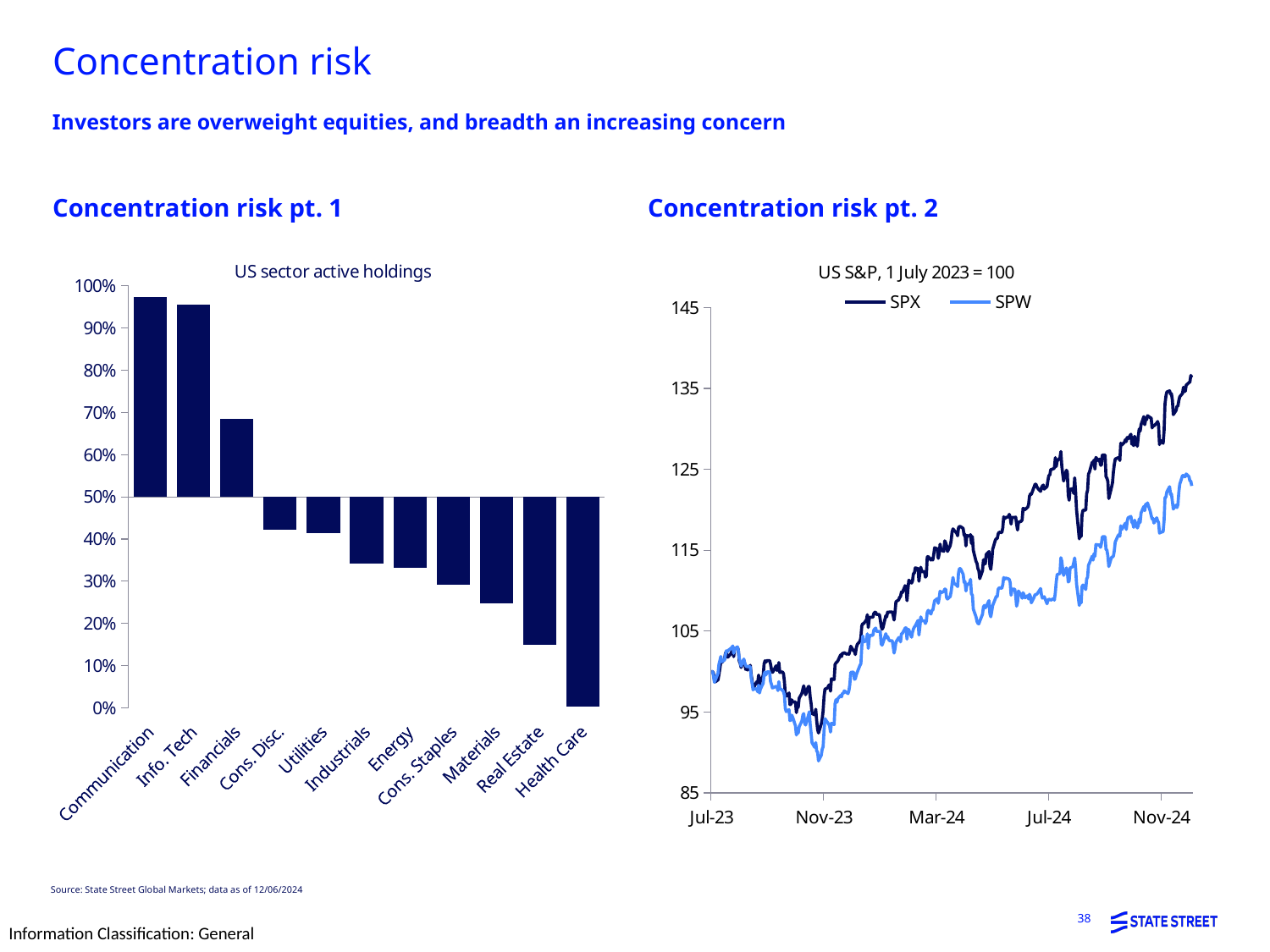
In 'Concentration risk pt. 2', how many series does the legend list? 2 In 'Concentration risk pt. 1', how many sectors are shown on the x axis? 11 In 'Concentration risk pt. 1', which sector has the lowest value? Health Care In 'Concentration risk pt. 2', is the SPX value at Nov-24 greater or less than 125? greater In 'Concentration risk pt. 2', which series is higher at Nov-24, SPX or SPW? SPX In 'Concentration risk pt. 1', is the value for Real Estate greater or less than 20%? less What type of chart is 'Concentration risk pt. 2'? line chart In 'Concentration risk pt. 1', is the value for Industrials greater or less than 40%? less What type of chart is 'Concentration risk pt. 1'? bar chart In 'Concentration risk pt. 2', do the SPX values generally rise or fall from Jul-23 to Nov-24? rise In 'Concentration risk pt. 1', which is larger, the value for Info. Tech or the value for Cons. Disc.? Info. Tech